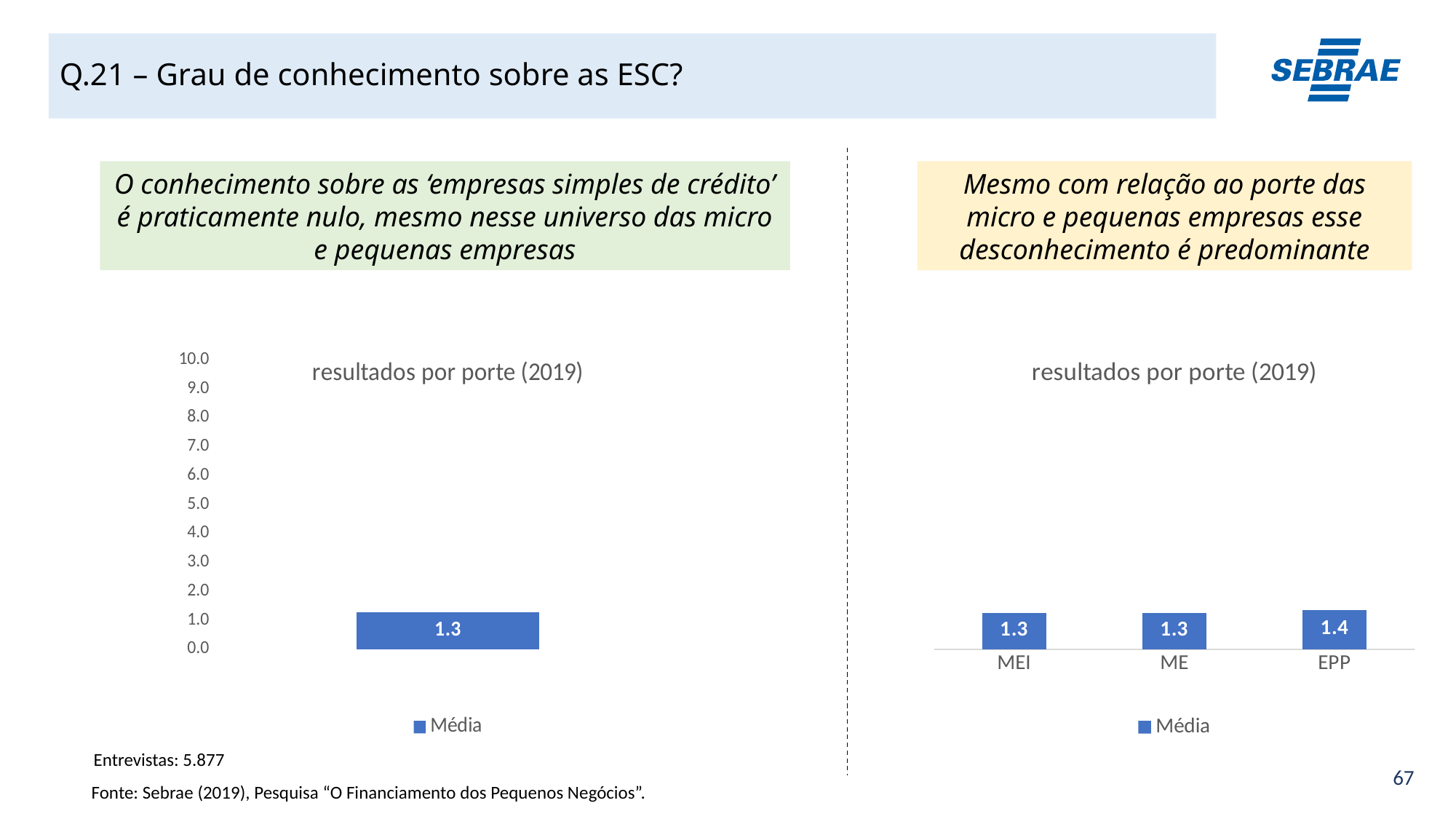
What is the title of the chart on the right? resultados por porte (2019) In the chart on the right, what is the value for EPP? 1.4 In the chart on the left, what value is printed on the single bar? 1.3 In the chart on the right, what is the value for MEI? 1.3 In the chart on the right, which category has the highest value? EPP How many series does the legend of the chart on the left list? 1 In the chart on the right, what is the value for ME? 1.3 In the chart on the right, what is the difference between the values for EPP and MEI? 0.1 In the chart on the left, is the value of the bar greater or less than 2.0? less What kind of chart is the chart on the right? bar chart What is the legend entry shown below the chart on the right? Média In the chart on the right, how many categories are shown on the x axis? 3